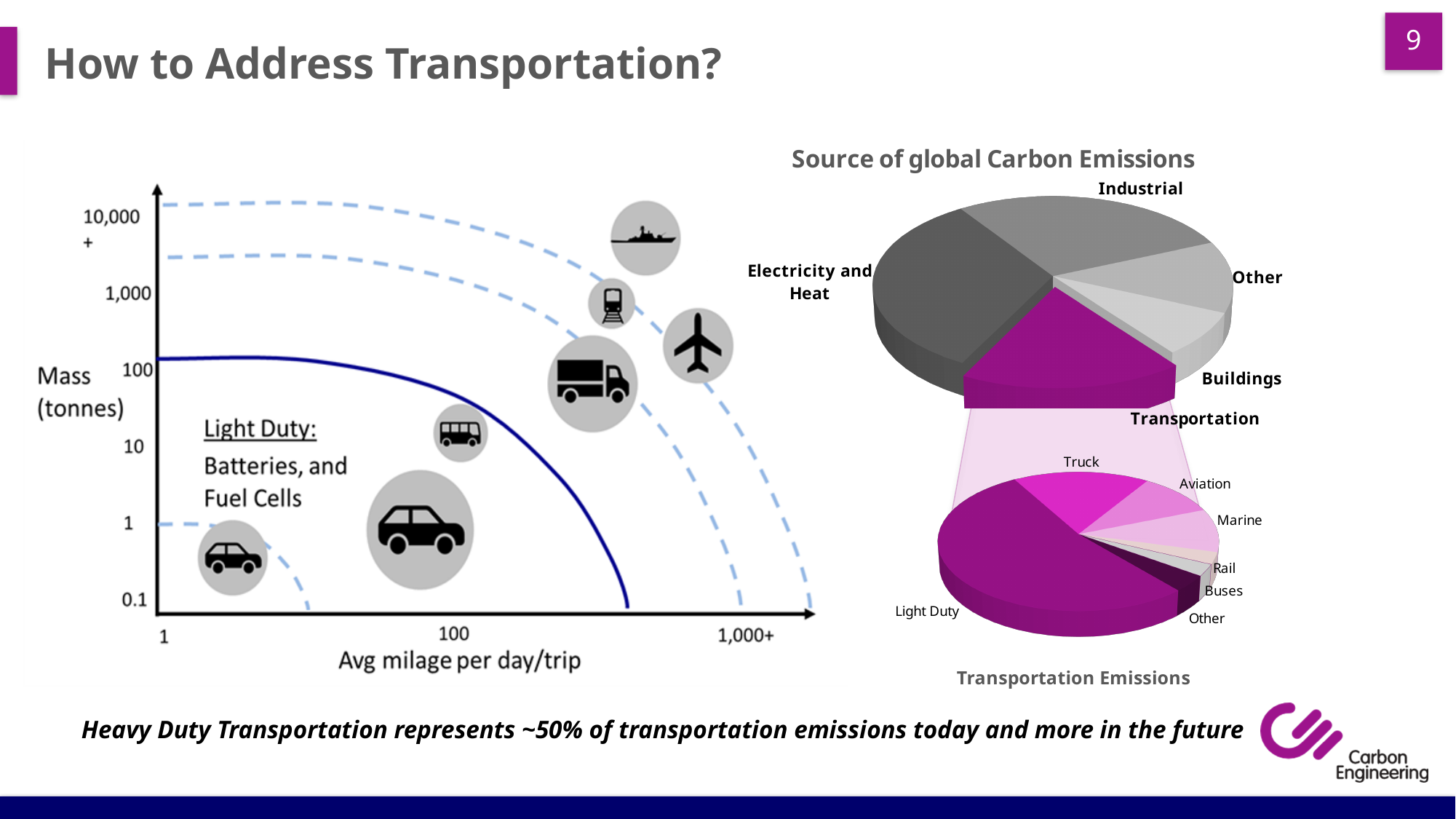
In the 'Source of global Carbon Emissions' chart, what kind of chart is shown? Pie chart In the 'Source of global Carbon Emissions' chart, which category has the largest slice? Electricity and Heat In the 'Source of global Carbon Emissions' chart, how many slices (categories) are shown? 5 In the 'Transportation Emissions' chart, which category has the largest slice? Light Duty In the 'Transportation Emissions' chart, how many slices (categories) are shown? 7 In the 'Source of global Carbon Emissions' chart, which slice is larger, Transportation or Buildings? Transportation What is the title of the lower pie chart on the right side of the slide? Transportation Emissions In the 'Source of global Carbon Emissions' chart, which slice is larger, Industrial or Buildings? Industrial In the 'Source of global Carbon Emissions' chart, which slice is pulled out and coloured purple? Transportation In the 'Transportation Emissions' chart, which slice is larger, Light Duty or Truck? Light Duty